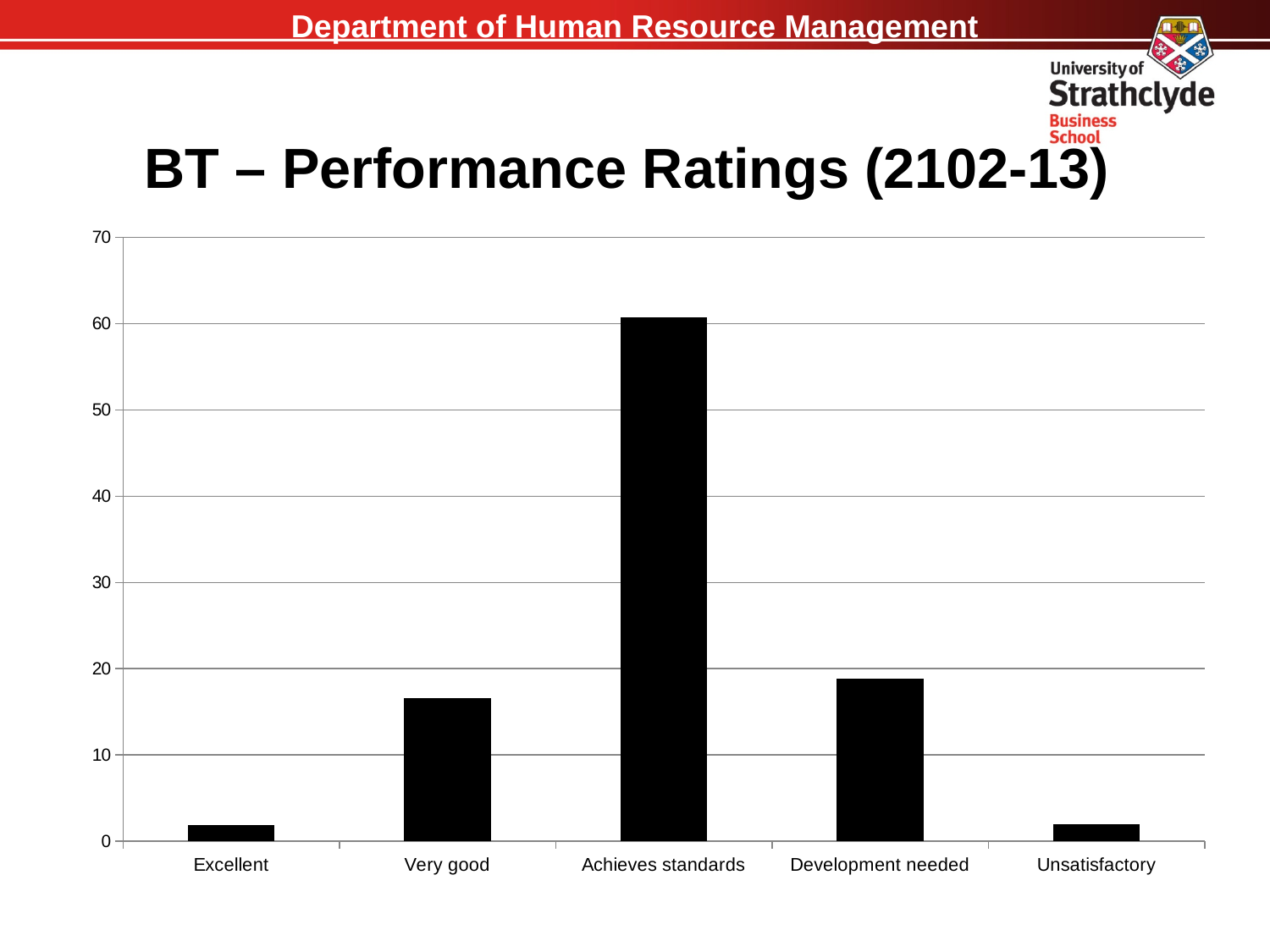
Which is larger, the value for Achieves standards or the value for Development needed? Achieves standards Is the value for Development needed greater or less than 10? greater Do the values rise or fall from Excellent to Achieves standards along the x axis? rise Is the value for Unsatisfactory greater or less than 10? less Which rating category has the highest value? Achieves standards Is the value for Very good greater or less than 20? less What kind of chart is shown on the slide? bar chart Which is larger, the value for Development needed or the value for Very good? Development needed How many rating categories are shown on the x axis? 5 What is the title of the chart on the slide? BT – Performance Ratings (2102-13)